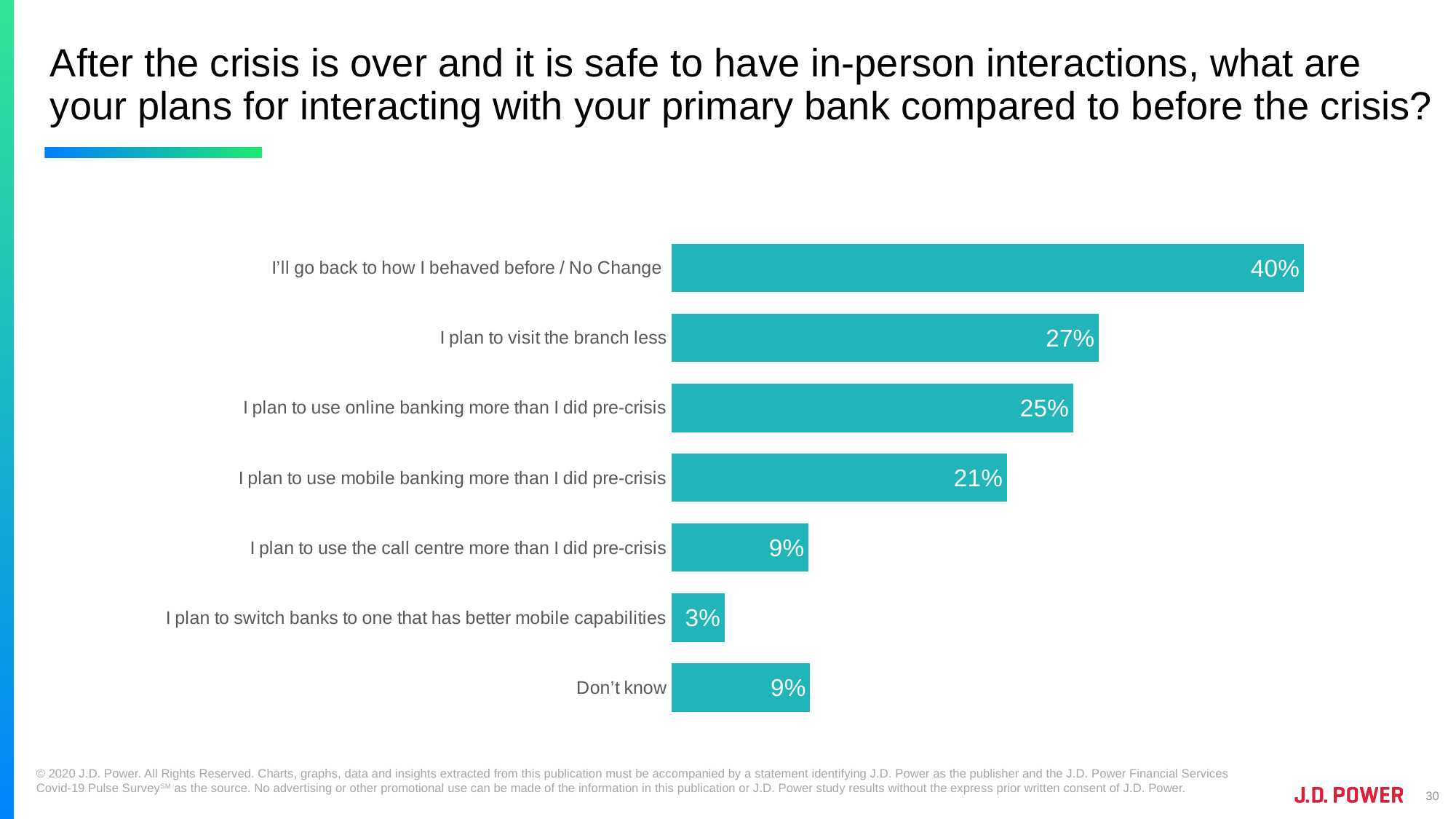
What percentage plan to use mobile banking more than they did pre-crisis? 21% Which is larger: "I plan to use online banking more than I did pre-crisis" or "I plan to use mobile banking more than I did pre-crisis"? I plan to use online banking more than I did pre-crisis Which category has the lowest value? I plan to switch banks to one that has better mobile capabilities What is the value for "I plan to visit the branch less"? 27% What colour are the bars in the chart? Teal How many categories are shown in the chart? 7 What percentage of respondents said they'll go back to how they behaved before / no change? 40% Which category has the highest value? I'll go back to how I behaved before / No Change What kind of chart is shown on the slide? Bar chart What is the difference between the highest value and the value for "Don't know"? 31% What is the difference between "I plan to visit the branch less" and "I plan to use online banking more than I did pre-crisis"? 2% What is the value for "I plan to switch banks to one that has better mobile capabilities"? 3%